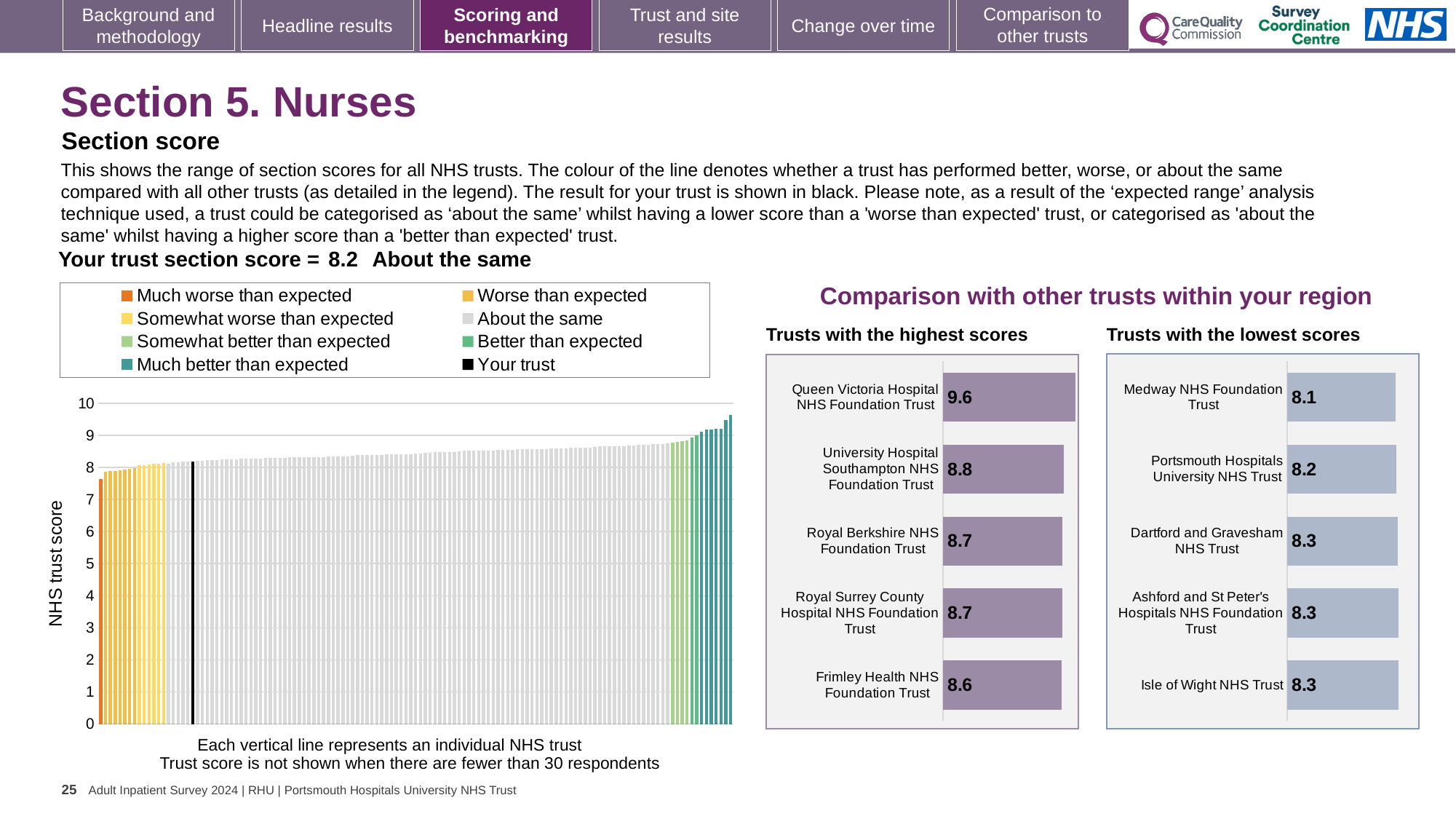
In the 'Trusts with the highest scores' chart, what is the score for Frimley Health NHS Foundation Trust? 8.6 In the 'Trusts with the lowest scores' chart, which trust has the lowest score? Medway NHS Foundation Trust In the 'Trusts with the highest scores' chart, what is the difference between the scores of Queen Victoria Hospital NHS Foundation Trust and University Hospital Southampton NHS Foundation Trust? 0.8 In the 'Trusts with the highest scores' chart, which trust has the highest score? Queen Victoria Hospital NHS Foundation Trust In the 'Trusts with the lowest scores' chart, what is the score for Medway NHS Foundation Trust? 8.1 How many trusts are shown in the 'Trusts with the highest scores' chart? 5 In the 'Trusts with the lowest scores' chart, how much higher is Portsmouth Hospitals University NHS Trust's score than Medway NHS Foundation Trust's score? 0.1 In the 'Trusts with the highest scores' chart, which has the larger score: Royal Berkshire NHS Foundation Trust or Frimley Health NHS Foundation Trust? Royal Berkshire NHS Foundation Trust What kind of chart is the 'Trusts with the lowest scores' chart? Bar chart In the 'Trusts with the lowest scores' chart, what is the score for Dartford and Gravesham NHS Trust? 8.3 In the main 'NHS trust score' chart on the left, is the value of the tallest bar greater or less than 9? greater In the 'Trusts with the highest scores' chart, what is the score for Queen Victoria Hospital NHS Foundation Trust? 9.6